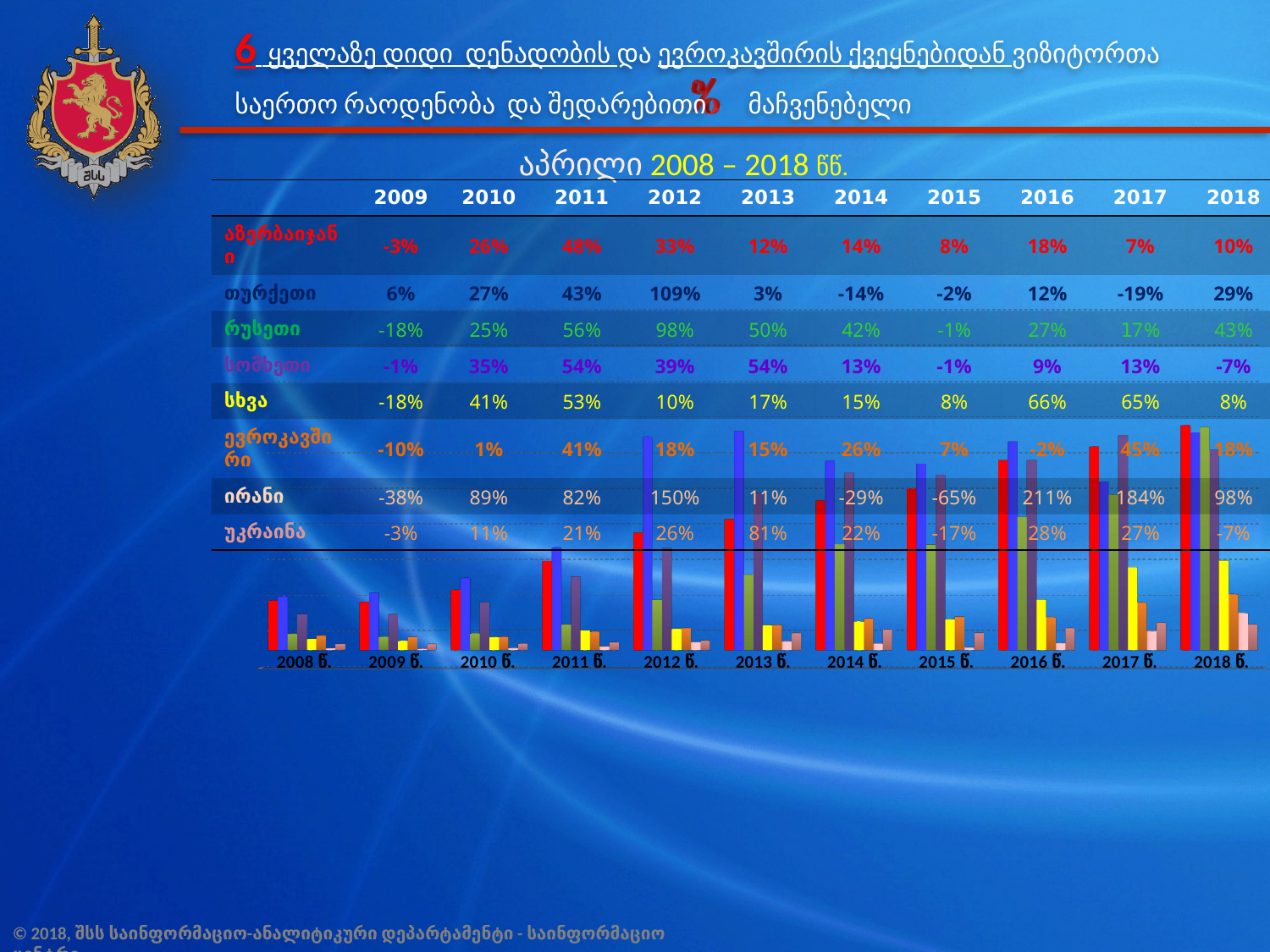
Is the red bar for 2018 taller or shorter than the red bar for 2008? taller In which year is the red bar the tallest? 2018 წ. How many year categories are shown along the x axis of the bar chart? 11 What kind of chart is shown at the bottom of the slide? bar chart Is the blue bar for 2013 taller or shorter than the blue bar for 2009? taller Do the yellow bars in the chart generally rise or fall from 2008 to 2017? rise Is the green bar for 2016 taller or shorter than the green bar for 2010? taller Do the red bars in the chart generally rise or fall from 2008 to 2018? rise What is the label of the first category on the x axis of the bar chart? 2008 წ. What is the label of the last category on the x axis of the bar chart? 2018 წ.